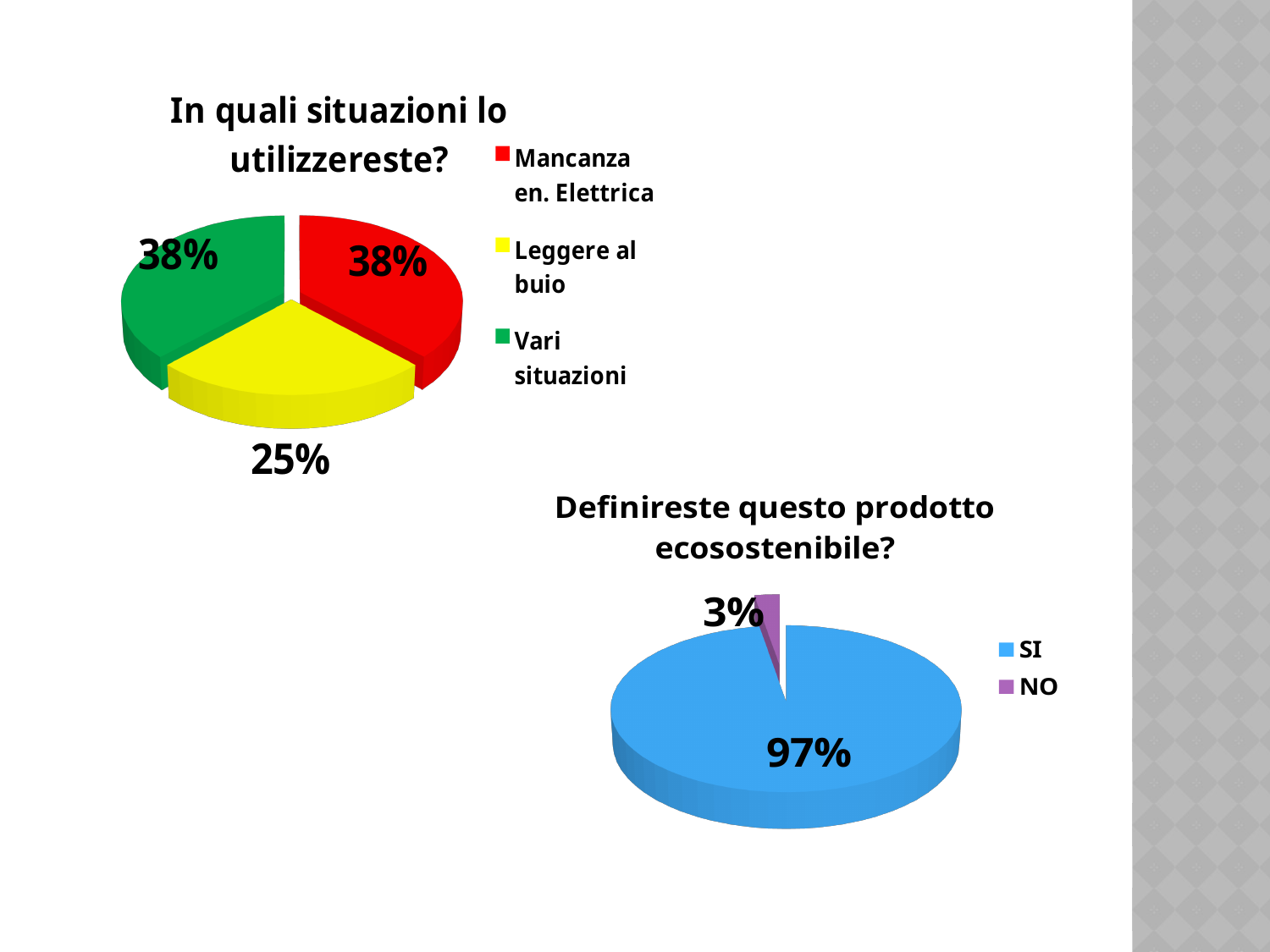
What kind of chart is the one titled "Definireste questo prodotto ecosostenibile?"? Pie chart In the chart titled "Definireste questo prodotto ecosostenibile?", what share does "SI" have? 97% In the chart titled "In quali situazioni lo utilizzereste?", what share does "Leggere al buio" have? 25% In the chart titled "In quali situazioni lo utilizzereste?", what share does "Vari situazioni" have? 38% In the chart titled "In quali situazioni lo utilizzereste?", what share does "Mancanza en. Elettrica" have? 38% In the chart titled "Definireste questo prodotto ecosostenibile?", what share does "NO" have? 3% In the chart titled "In quali situazioni lo utilizzereste?", what is the difference between the shares of "Mancanza en. Elettrica" and "Leggere al buio"? 13% In the chart titled "In quali situazioni lo utilizzereste?", how many categories does the legend list? 3 In the chart titled "Definireste questo prodotto ecosostenibile?", what is the difference between the shares of "SI" and "NO"? 94% In the chart titled "Definireste questo prodotto ecosostenibile?", which category has the largest slice? SI In the chart titled "In quali situazioni lo utilizzereste?", what colour is the "Leggere al buio" slice? Yellow In the chart titled "In quali situazioni lo utilizzereste?", which category has the smallest slice? Leggere al buio